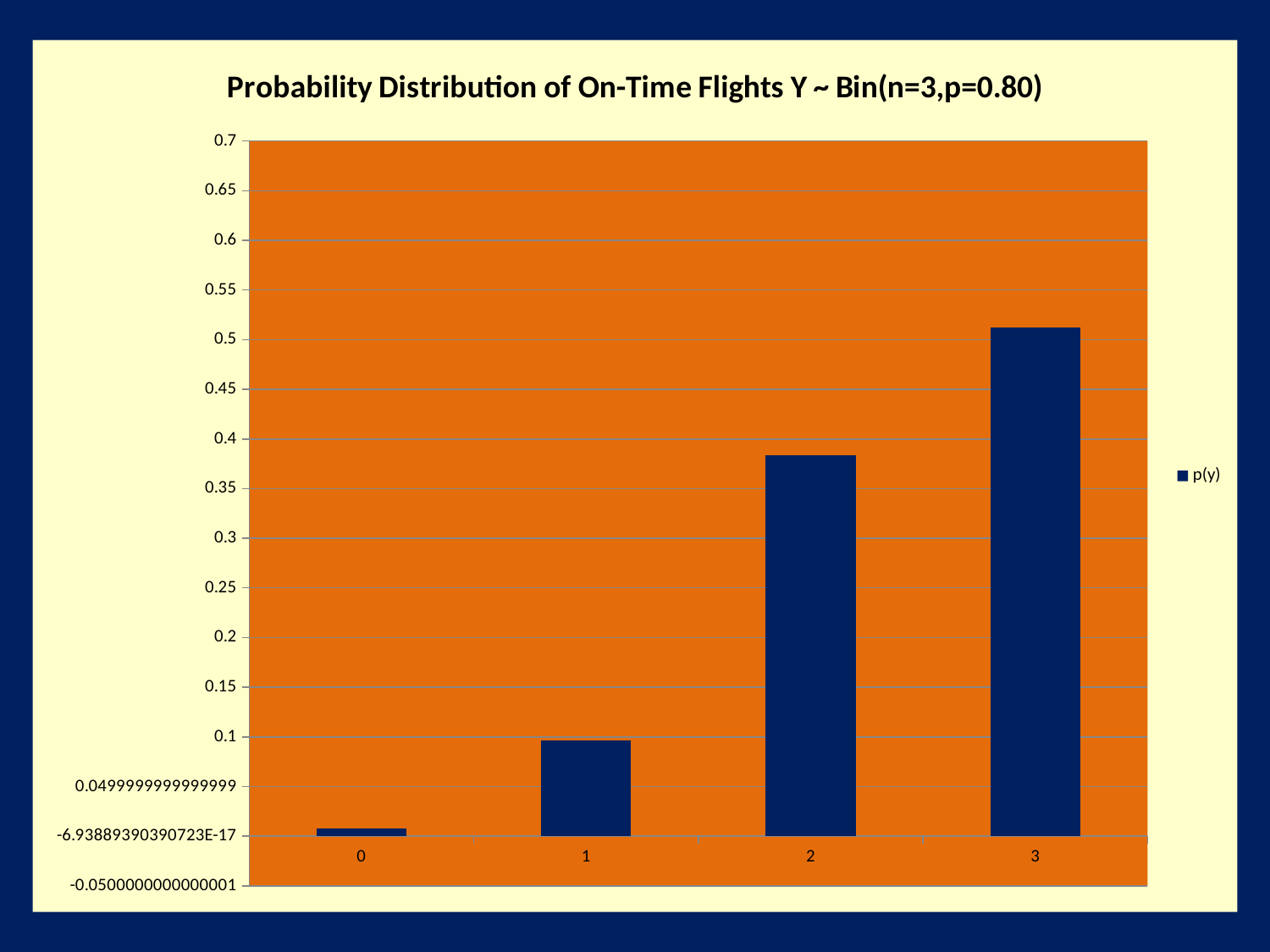
What is the name of the series shown in the legend? p(y) How many categories are shown on the x axis? 4 Which is larger, the value for 2 or the value for 1? 2 What is the title of the chart? Probability Distribution of On-Time Flights Y ~ Bin(n=3,p=0.80) Is the value for 2 greater or less than 0.35? greater Is the value for 1 greater or less than 0.15? less Do the values rise or fall as the x axis goes from 0 to 3? rise What kind of chart is shown on the slide? bar chart Which category has the highest bar? 3 How many series does the legend list? 1 Is the value for 3 greater or less than 0.45? greater Which category has the lowest bar? 0